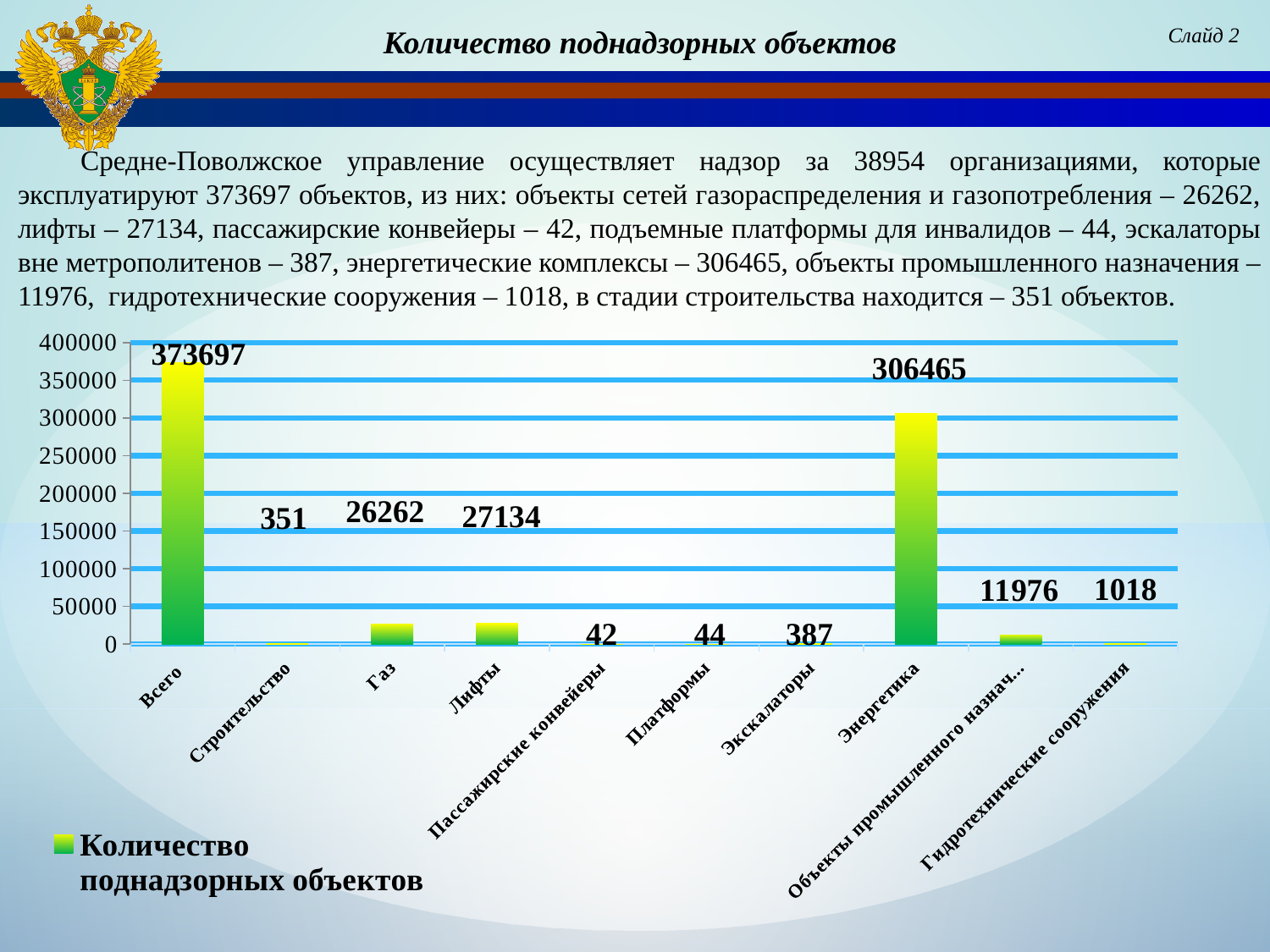
Which category has the highest value in the chart? Всего How many series does the chart legend list? 1 Is the value for Энергетика greater or less than 300000? greater What type of chart is shown on the slide? bar chart How many categories are shown on the x axis of the chart? 10 Which is larger, the value for Платформы or the value for Пассажирские конвейеры? Платформы What is the value for Энергетика in the chart? 306465 Which category has the lowest value in the chart? Пассажирские конвейеры What is the difference between the values for Лифты and Газ? 872 What is the value for Лифты in the chart? 27134 What is the value for Эскалаторы in the chart? 387 What is the value for Газ in the chart? 26262